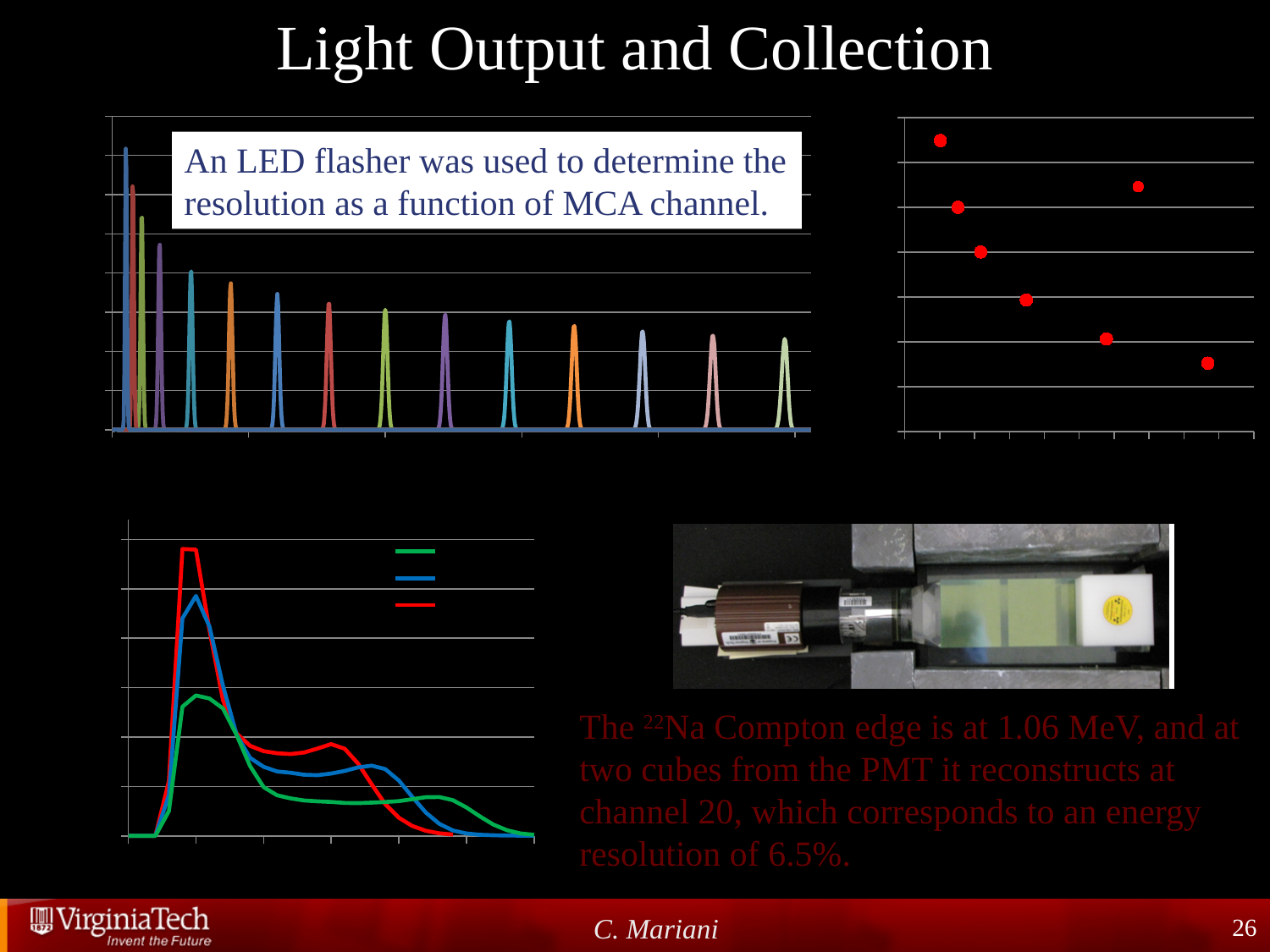
What colours are the three legend entries in the bottom-left chart, from top to bottom? green, blue, red In the top-left chart, do the peak heights rise or fall from left to right along the x axis? fall How many series does the legend of the bottom-left chart list? 3 In the top-right scatter chart, is the lowest point the leftmost or the rightmost point? the rightmost point What kind of chart is the top-right chart on the slide? scatter chart In the bottom-left chart, which peak is higher, the red series or the blue series? the red series In the bottom-left chart, which series reaches the highest peak? the red series In the bottom-left chart, which series has the lowest peak? the green series What kind of chart is the bottom-left chart on the slide? line chart How many data points are plotted in the top-right scatter chart? 7 In the top-right scatter chart, is the highest point the leftmost or the rightmost point? the leftmost point What kind of chart is the top-left chart on the slide? line chart